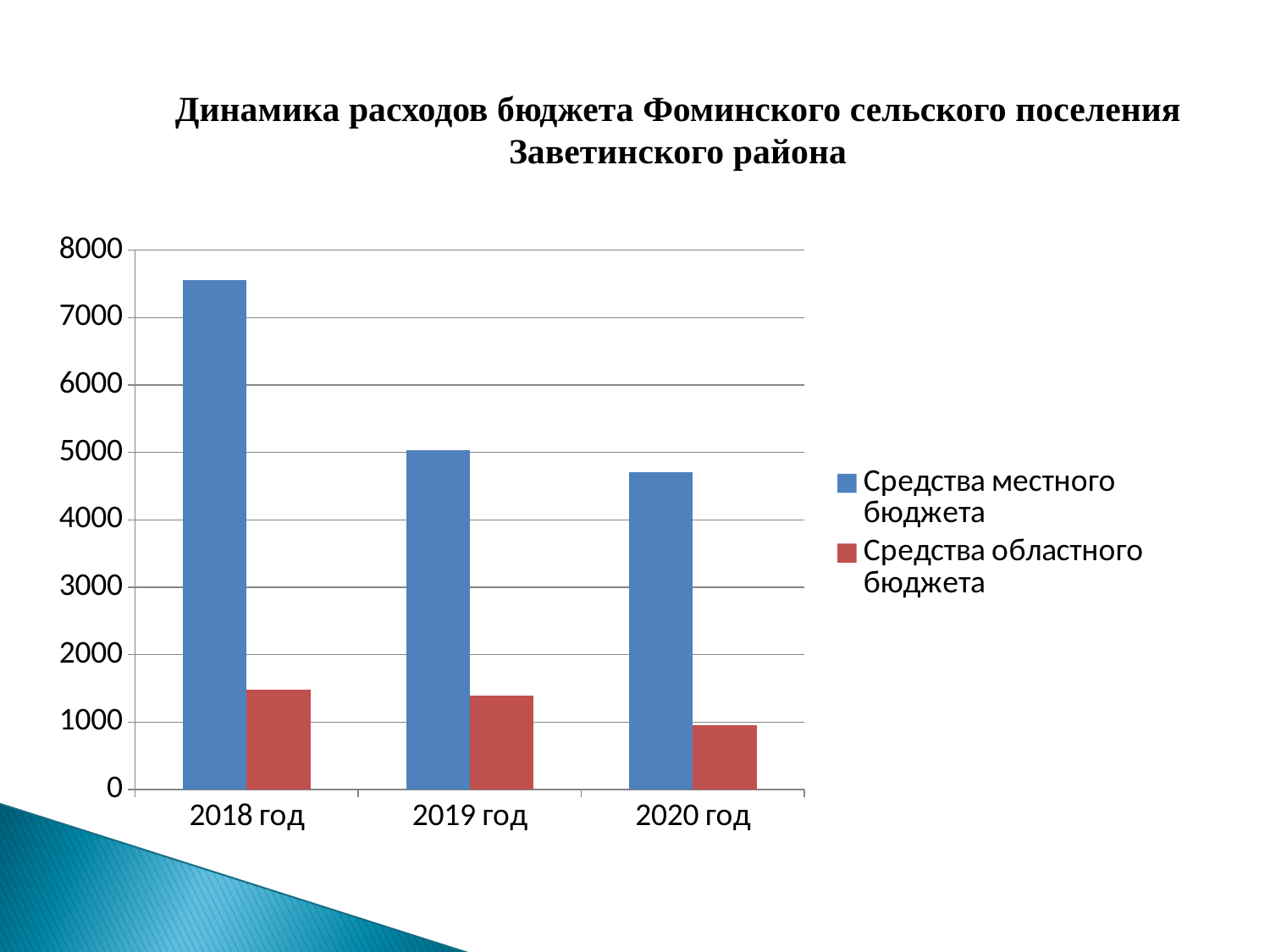
How many years (categories) are shown on the x axis? 3 Do the values for Средства местного бюджета rise or fall from 2018 год to 2020 год? Fall Which year has the lowest value for Средства областного бюджета? 2020 год Which year has the highest value for Средства местного бюджета? 2018 год In 2019 год, which is larger: Средства местного бюджета or Средства областного бюджета? Средства местного бюджета Is the value for Средства местного бюджета in 2020 год greater or less than 5000? less Is the value for Средства областного бюджета in 2018 год greater or less than 1000? greater Is the value for Средства областного бюджета in 2020 год greater or less than 2000? less How many series does the legend list? 2 Which year has the lowest value for Средства местного бюджета? 2020 год What kind of chart is shown on the slide? Bar chart